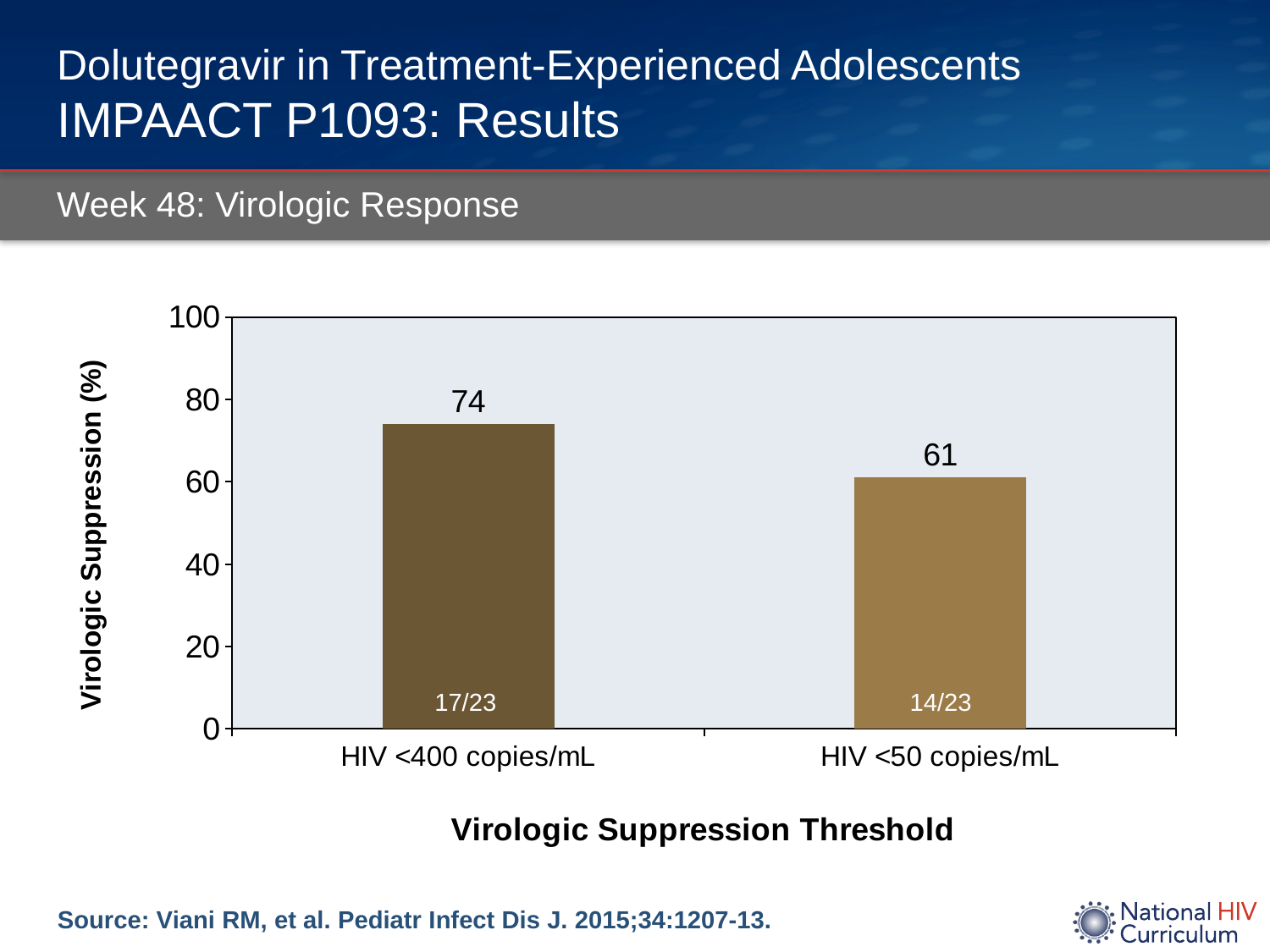
What is the virologic suppression percentage for HIV <50 copies/mL? 61 Which virologic suppression threshold has the highest suppression percentage? HIV <400 copies/mL What fraction of participants is shown inside the bar for HIV <50 copies/mL? 14/23 Is the value for HIV <50 copies/mL greater or less than 80? less Which virologic suppression threshold has the lowest suppression percentage? HIV <50 copies/mL How many categories are shown on the x axis? 2 What is the label of the x axis? Virologic Suppression Threshold What is the virologic suppression percentage for HIV <400 copies/mL? 74 What fraction of participants is shown inside the bar for HIV <400 copies/mL? 17/23 What kind of chart is shown on the slide? bar chart Which is larger, the value for HIV <400 copies/mL or the value for HIV <50 copies/mL? HIV <400 copies/mL What is the difference in virologic suppression percentage between HIV <400 copies/mL and HIV <50 copies/mL? 13